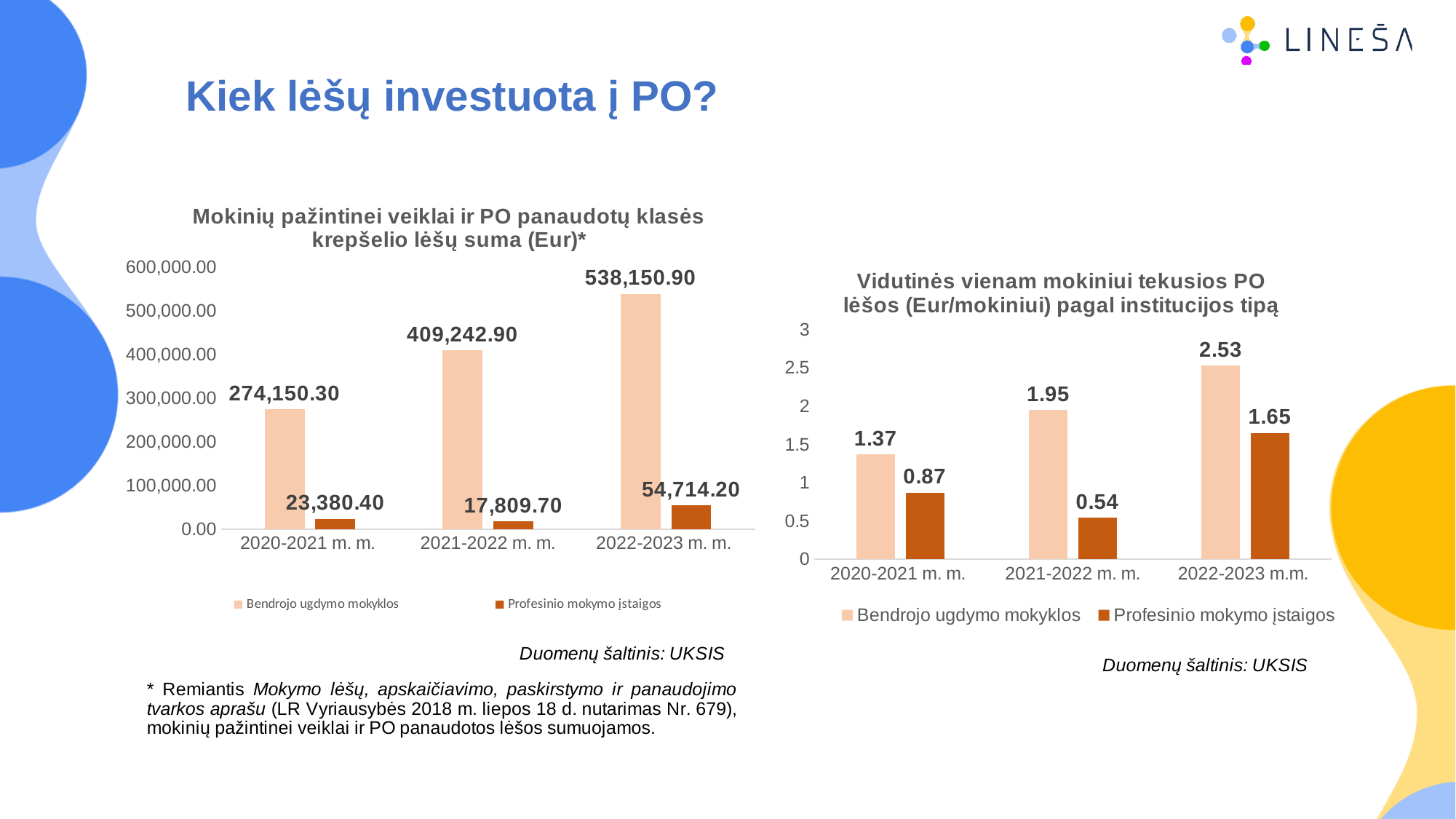
In the left chart, does the value for Bendrojo ugdymo mokyklos rise or fall from 2020-2021 m. m. to 2022-2023 m. m.? rise In the left chart (Mokinių pažintinei veiklai ir PO panaudotų klasės krepšelio lėšų suma), what is the value for Bendrojo ugdymo mokyklos in 2022-2023 m. m.? 538,150.90 In the right chart, what is the difference between Bendrojo ugdymo mokyklos and Profesinio mokymo įstaigos in 2022-2023 m.m.? 0.88 How many series does the legend of the right chart list? 2 In the left chart, which school year has the lowest value for Profesinio mokymo įstaigos? 2021-2022 m. m. In the left chart, what is the difference between the Bendrojo ugdymo mokyklos values for 2022-2023 m. m. and 2021-2022 m. m.? 128,908.00 In the right chart, which is larger in 2021-2022 m. m.: Bendrojo ugdymo mokyklos or Profesinio mokymo įstaigos? Bendrojo ugdymo mokyklos In the right chart (Vidutinės vienam mokiniui tekusios PO lėšos), what is the value for Profesinio mokymo įstaigos in 2020-2021 m. m.? 0.87 In the right chart, what is the value for Bendrojo ugdymo mokyklos in 2021-2022 m. m.? 1.95 What kind of chart is the left chart? bar chart In the right chart, which school year has the highest value for Bendrojo ugdymo mokyklos? 2022-2023 m.m. In the left chart, what is the value for Profesinio mokymo įstaigos in 2021-2022 m. m.? 17,809.70